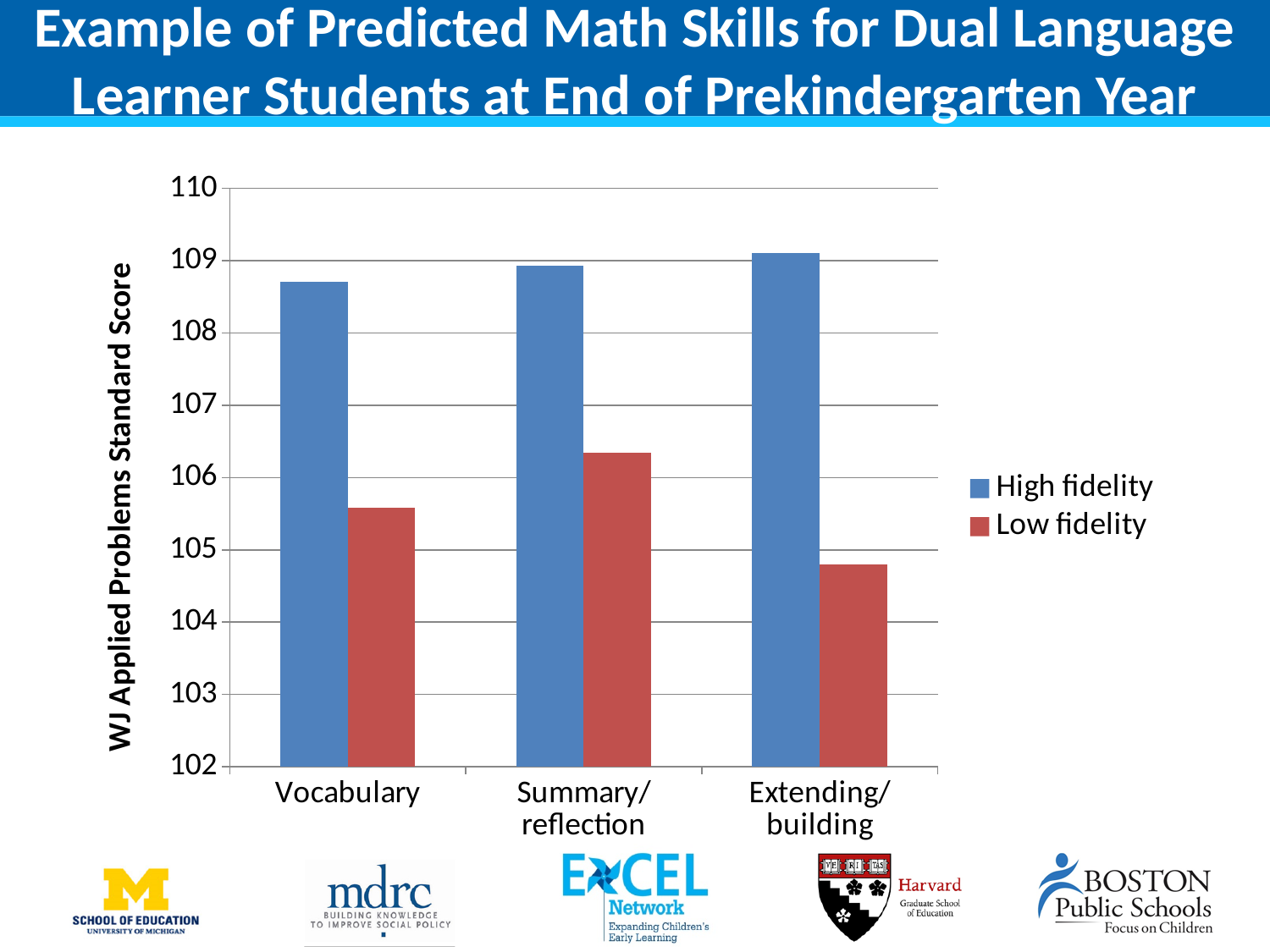
Is the Low fidelity value for Extending/building greater or less than 105? less What is the label of the y axis? WJ Applied Problems Standard Score How many categories are shown on the x axis? 3 Do the High fidelity values rise or fall from Vocabulary to Extending/building? rise How many series does the legend list? 2 Is the High fidelity value for Summary/reflection greater or less than 108? greater For Vocabulary, which is larger: High fidelity or Low fidelity? High fidelity Which category has the lowest Low fidelity value? Extending/building Is the Low fidelity value for Summary/reflection greater or less than 106? greater Which category has the highest High fidelity value? Extending/building What kind of chart is shown on the slide? bar chart Which category has the highest Low fidelity value? Summary/reflection